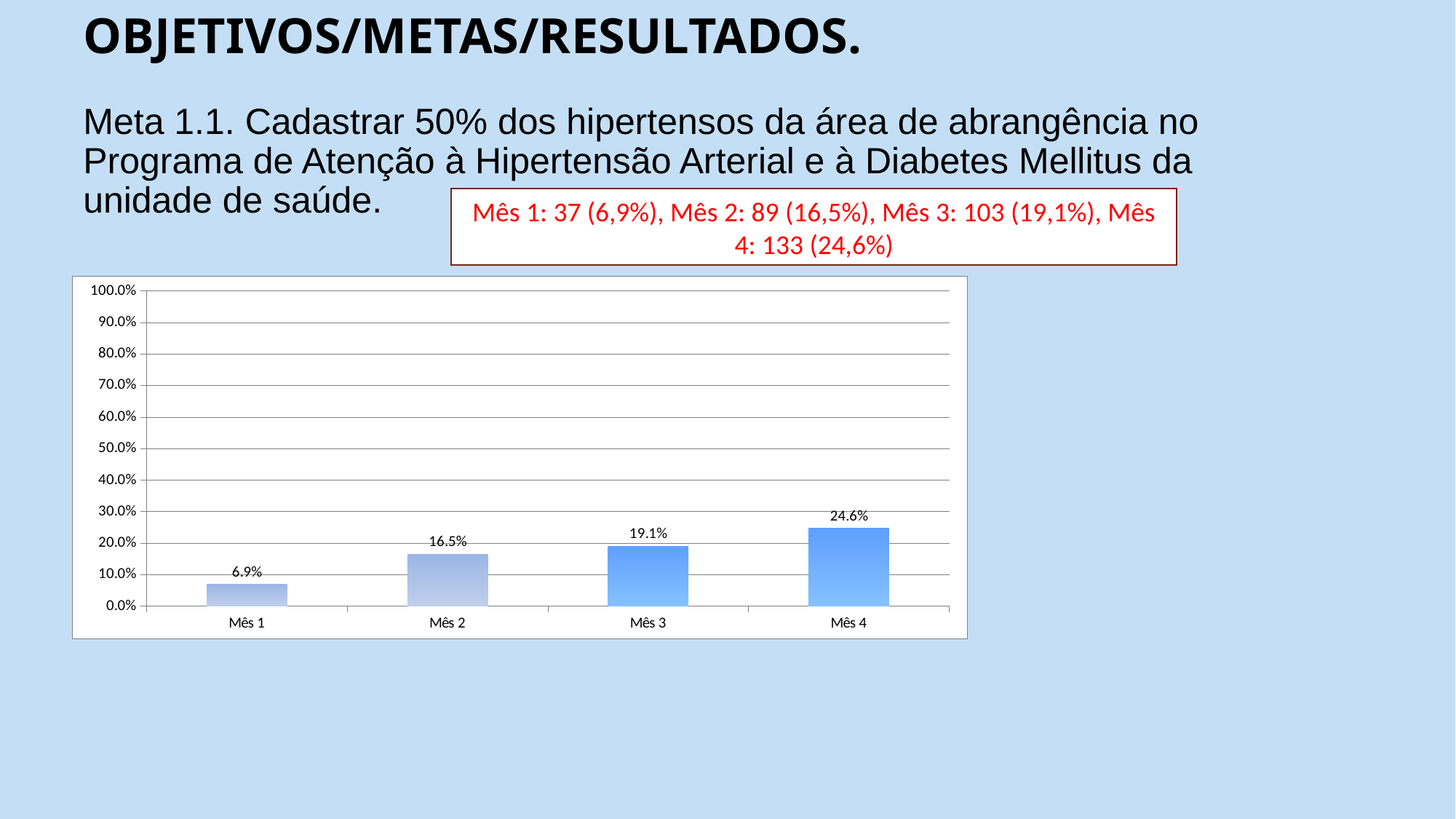
What kind of chart is shown on the slide? bar chart What is the value for Mês 2? 16.5% What is the difference between the values for Mês 4 and Mês 1? 17.7% Which is larger, the value for Mês 2 or the value for Mês 3? Mês 3 What is the value for Mês 4? 24.6% Which month has the lowest value? Mês 1 What is the difference between the values for Mês 2 and Mês 1? 9.6% What is the value for Mês 3? 19.1% What is the value for Mês 1? 6.9% Is the value for Mês 4 greater or less than 50.0%? less How many months are shown on the x axis? 4 Which month has the highest value? Mês 4